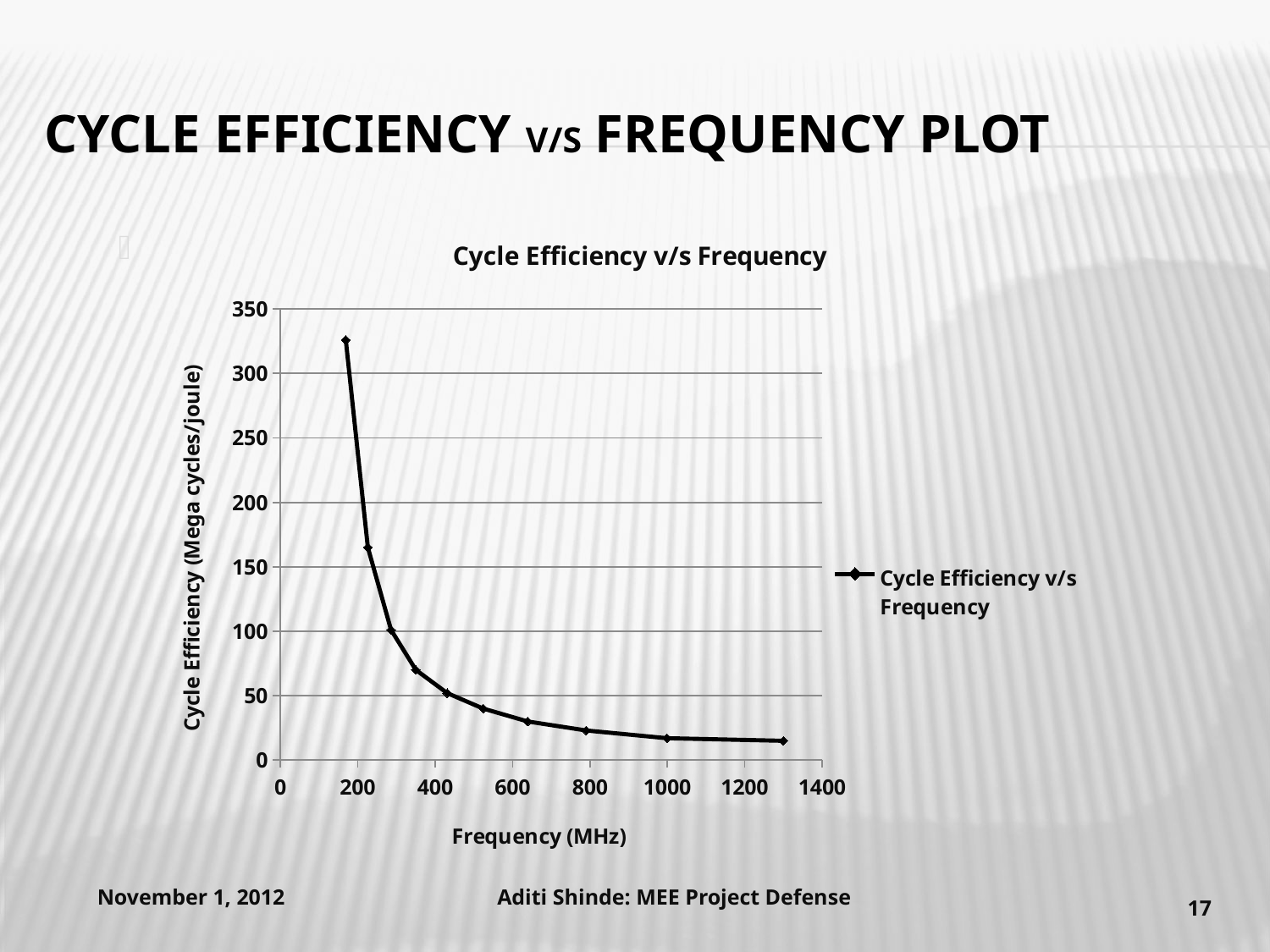
What is the label of the x axis? Frequency (MHz) Does the highest cycle efficiency occur at the lowest or the highest plotted frequency? Lowest frequency What is the title of the chart? Cycle Efficiency v/s Frequency How many data points are plotted on the line? 10 Is the cycle efficiency of the second data point (just above 200 MHz) greater or less than 150? greater Is the cycle efficiency at the highest plotted frequency (around 1300 MHz) greater or less than 50? less How many series does the legend list? 1 What kind of chart is shown on the slide? Line chart Is the cycle efficiency of the first (leftmost) data point greater or less than 300? greater Does cycle efficiency rise or fall as frequency increases along the x axis? Fall Which is larger: the cycle efficiency at the leftmost point or at the rightmost point? Leftmost point